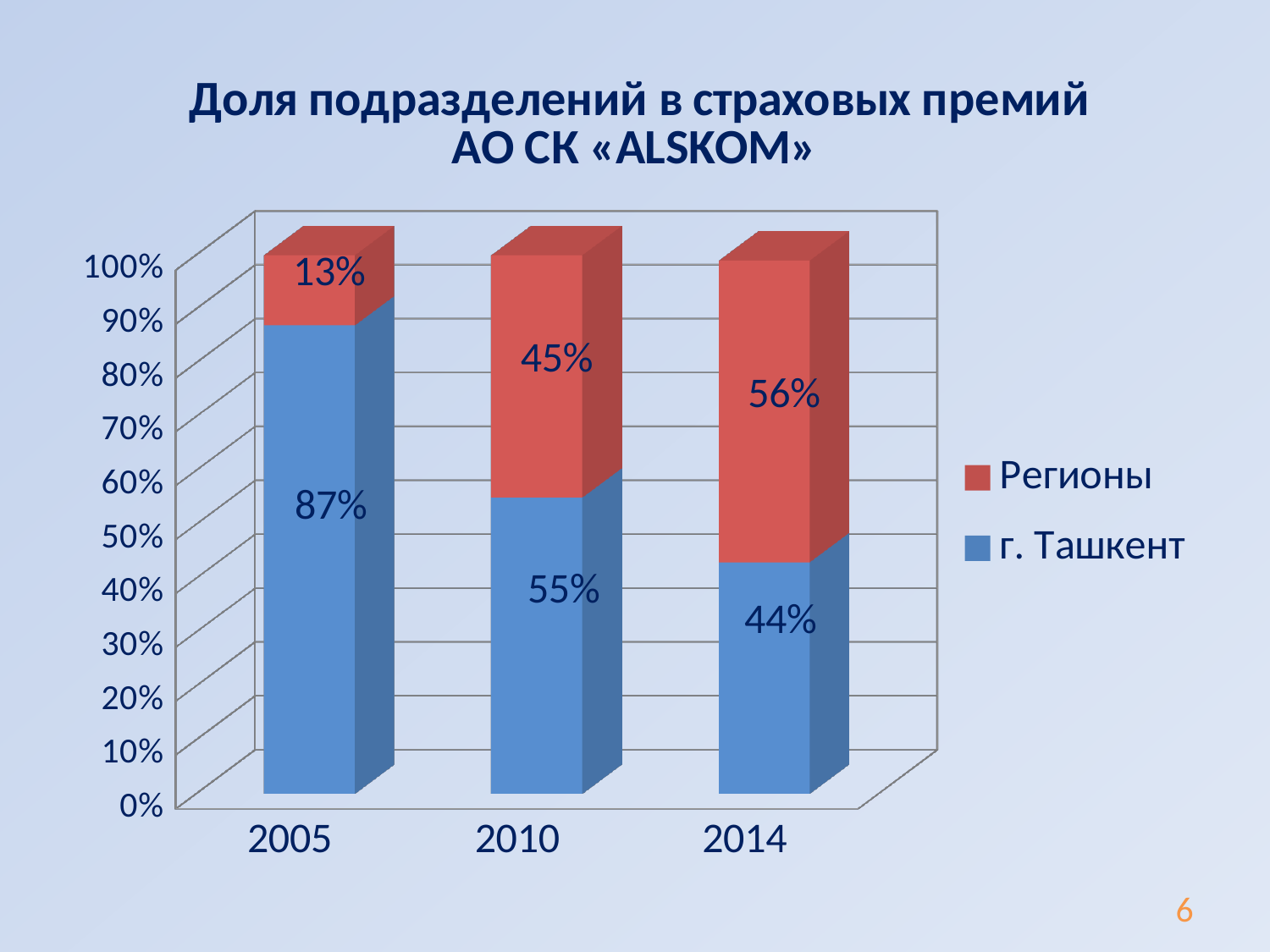
What is the value for г. Ташкент in 2014? 44% What is the value for Регионы in 2010? 45% How many series does the legend list? 2 In which year is the share of г. Ташкент the lowest? 2014 What kind of chart is shown on the slide? Stacked bar chart What is the difference between the г. Ташкент share in 2005 and in 2014? 43% Does the share of Регионы rise or fall from 2005 to 2014? Rise What is the value for Регионы in 2014? 56% In which year is the share of Регионы the highest? 2014 How many years are shown on the x axis? 3 Which is larger in 2010: the share of г. Ташкент or the share of Регионы? г. Ташкент What is the value for г. Ташкент in 2005? 87%